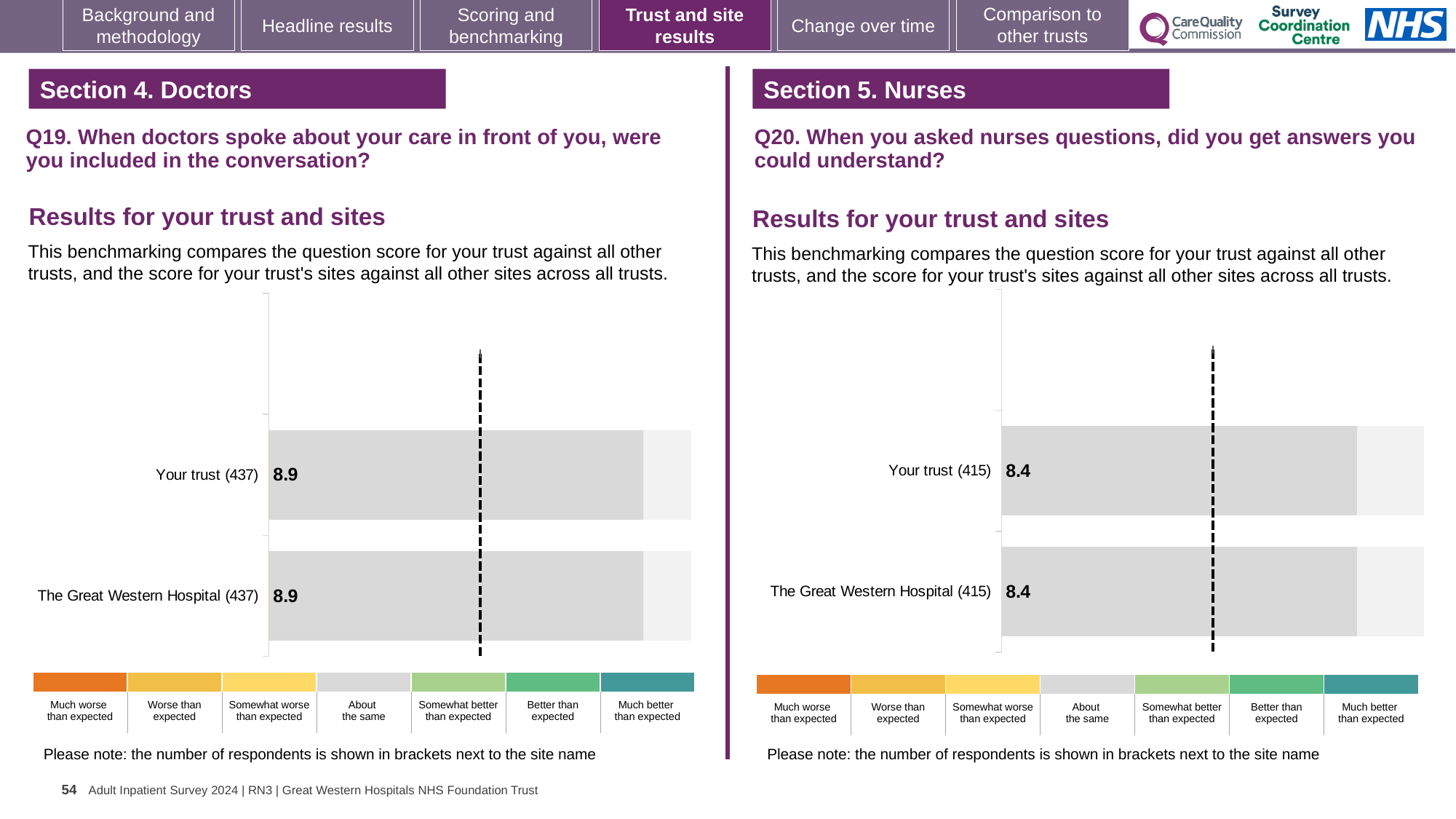
What kind of chart is used for the Q19 results on the left? Bar chart Is the score for Your trust in the Q19 chart on the left larger or smaller than the score for Your trust in the Q20 chart on the right? Larger How many bars are plotted in the Q19 chart on the left? 2 In the Q20 chart on the right, what is the difference between the score for Your trust and the score for The Great Western Hospital? 0.0 In the Q19 chart on the left, what is the difference between the score for Your trust and the score for The Great Western Hospital? 0.0 In the Q19 chart on the left, how many respondents are shown in brackets next to Your trust? 437 In the Q20 chart on the right, how many respondents are shown in brackets next to The Great Western Hospital? 415 In the Q19 chart on the left, what is the score for The Great Western Hospital? 8.9 In the Q19 chart on the left, what is the score for Your trust? 8.9 In the Q20 chart on the right, what is the score for Your trust? 8.4 In the Q20 chart on the right, what is the score for The Great Western Hospital? 8.4 How many bars are plotted in the Q20 chart on the right? 2